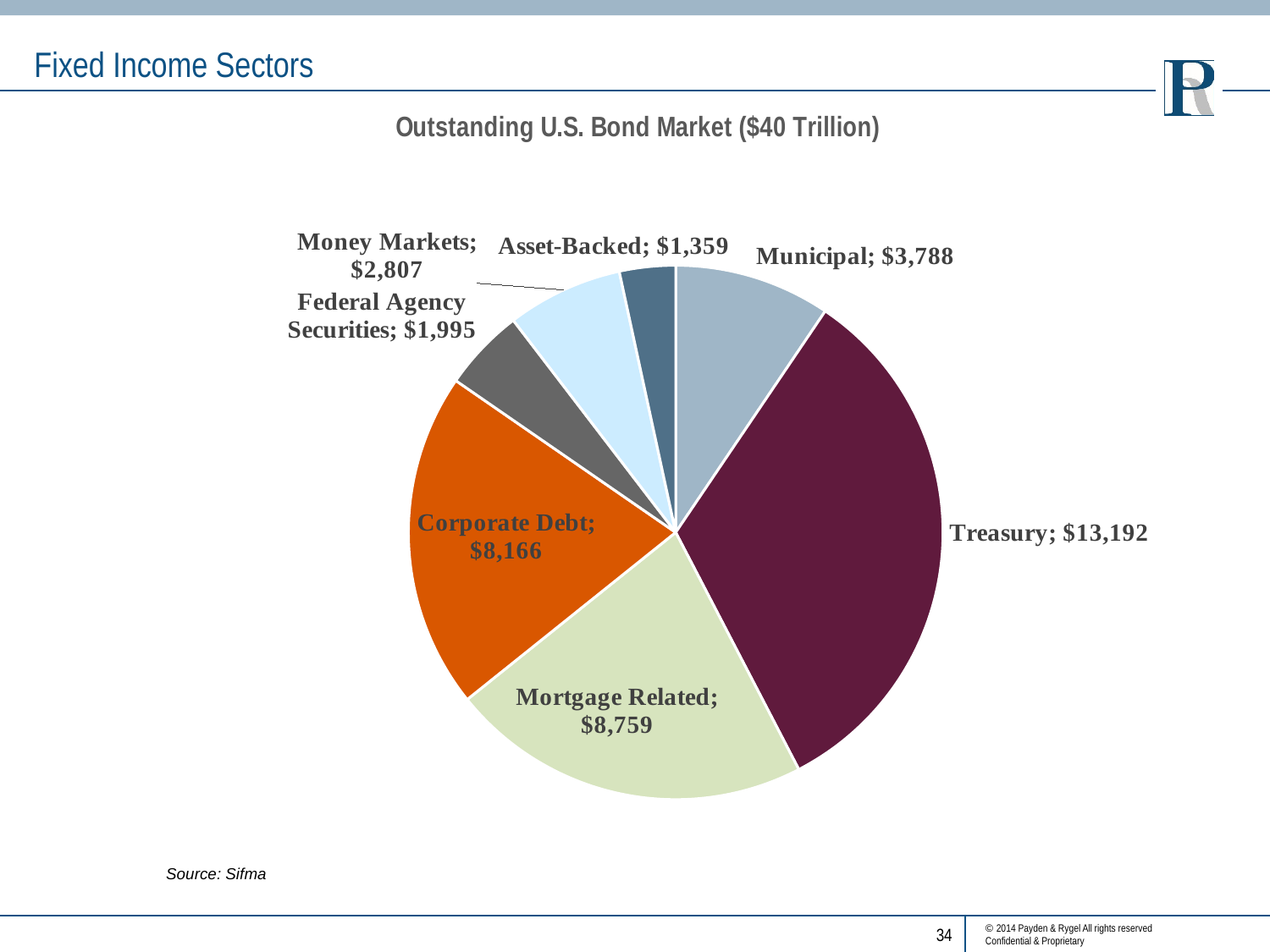
Which sector has the largest slice of the pie? Treasury What type of chart is shown on the slide? Pie chart How many sectors are shown in the pie chart? 7 What is the value shown for Asset-Backed? $1,359 What is the title of the chart? Outstanding U.S. Bond Market ($40 Trillion) Which sector has the smallest slice of the pie? Asset-Backed What is the value shown for Mortgage Related? $8,759 What is the value shown for Federal Agency Securities? $1,995 What is the difference between the Treasury value and the Mortgage Related value? $4,433 Which is larger, Corporate Debt or Municipal? Corporate Debt What is the difference between the Money Markets value and the Federal Agency Securities value? $812 What is the value shown for Treasury? $13,192